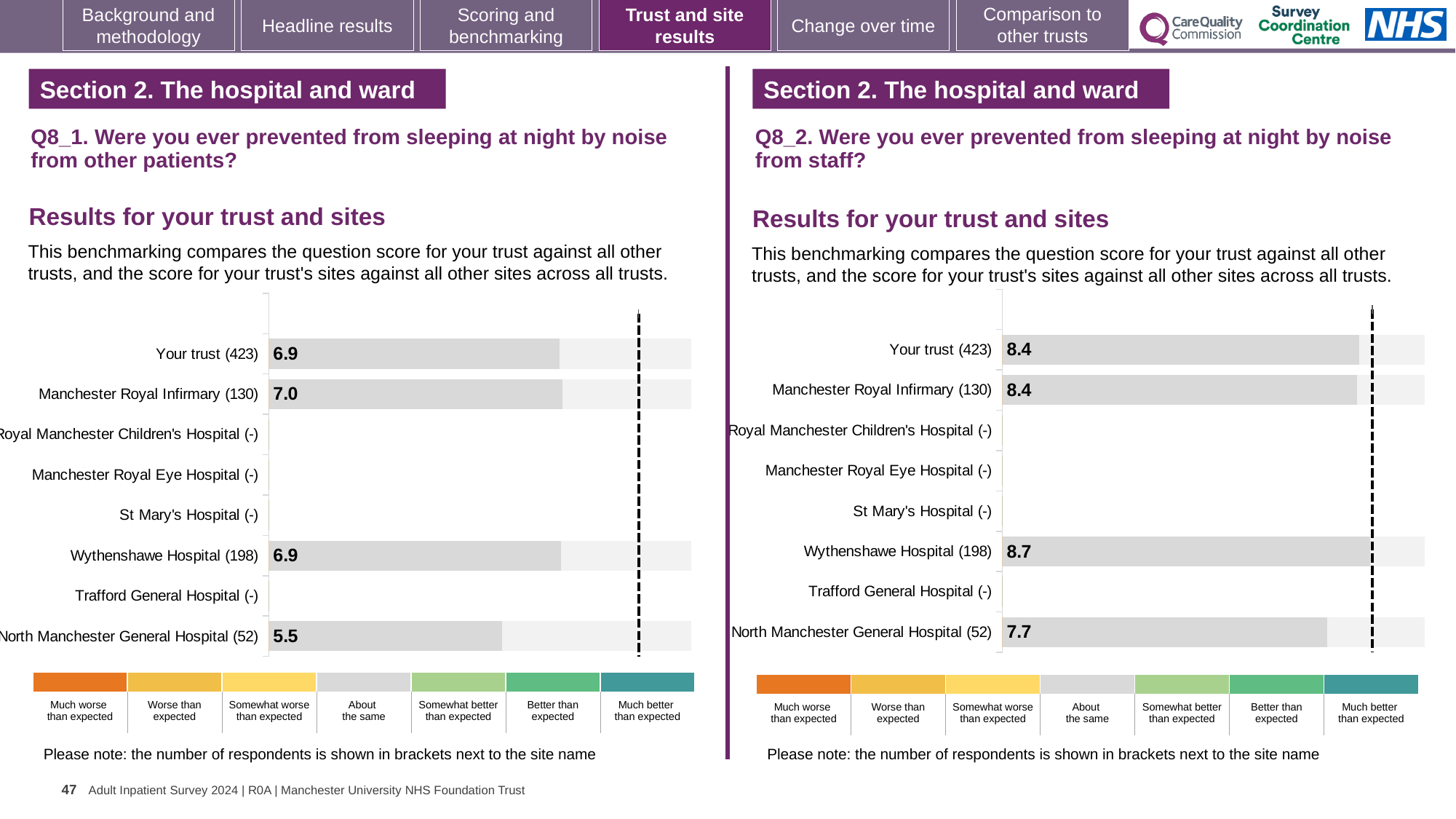
On the Q8_1 chart (noise from other patients), what is the difference between the scores for Manchester Royal Infirmary (130) and North Manchester General Hospital (52)? 1.5 On the Q8_2 chart (noise from staff), which site with a plotted score has the highest score? Wythenshawe Hospital (198) What kind of chart is used on the Q8_2 chart (noise from staff)? Bar chart On the Q8_2 chart (noise from staff), what is the difference between the scores for Wythenshawe Hospital (198) and North Manchester General Hospital (52)? 1.0 On the Q8_1 chart (noise from other patients), which is larger: the score for Manchester Royal Infirmary (130) or North Manchester General Hospital (52)? Manchester Royal Infirmary (130) How many benchmark categories are shown in the colour legend below the Q8_1 chart (noise from other patients)? 7 On the Q8_1 chart (noise from other patients), what is the score for Your trust (423)? 6.9 On the Q8_1 chart (noise from other patients), what is the score for North Manchester General Hospital (52)? 5.5 How many site/trust rows are listed on the Q8_1 chart (noise from other patients)? 8 On the Q8_2 chart (noise from staff), what is the score for Your trust (423)? 8.4 On the Q8_1 chart (noise from other patients), which site with a plotted score has the lowest score? North Manchester General Hospital (52) On the Q8_2 chart (noise from staff), what is the score for Wythenshawe Hospital (198)? 8.7